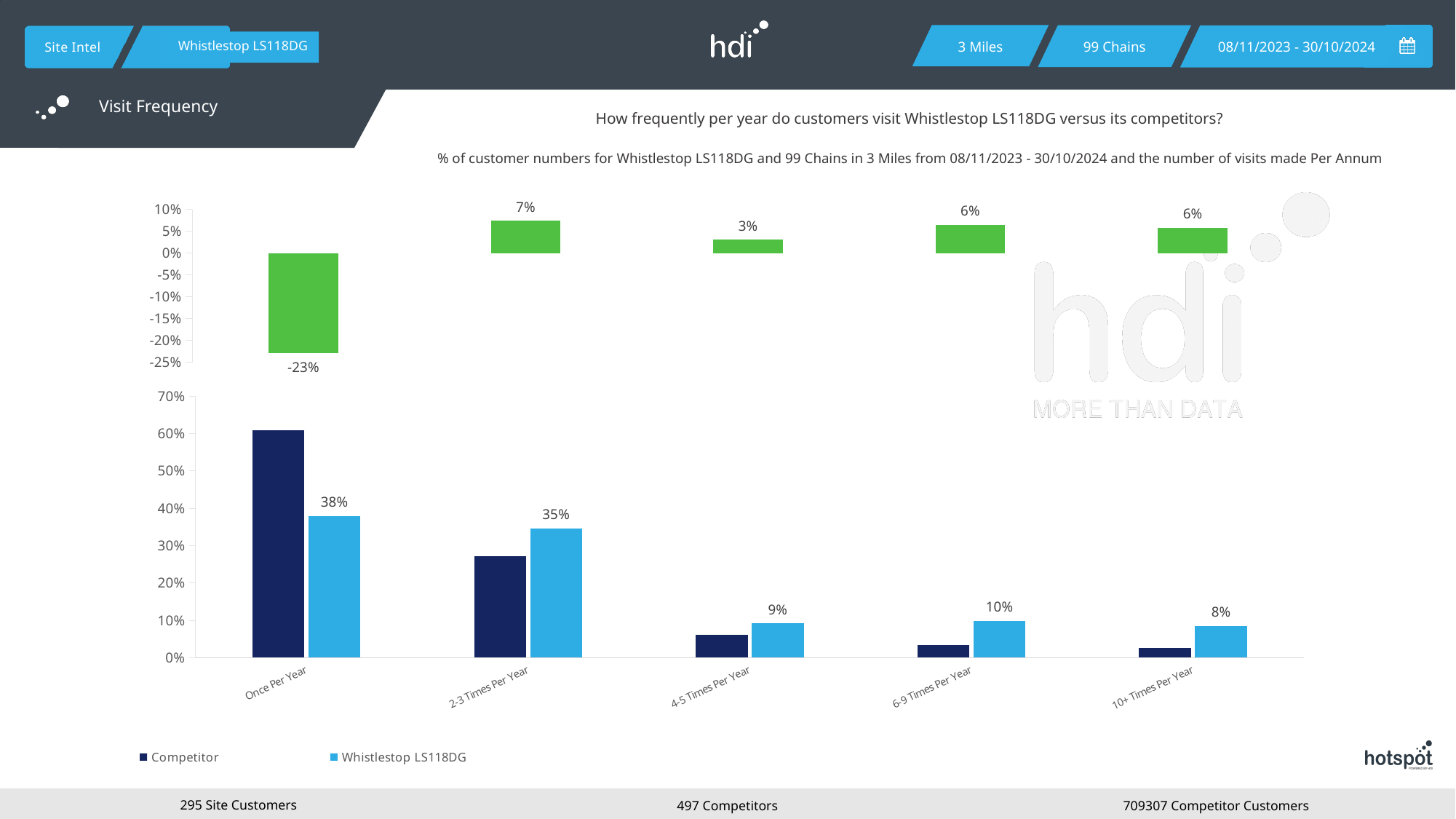
In the bottom chart, for Once Per Year, which series has the larger value: Competitor or Whistlestop LS118DG? Competitor In the bottom chart, is the Competitor value for Once Per Year greater or less than 50%? greater In the bottom chart, which category has the highest Whistlestop LS118DG value? Once Per Year In the top chart (green bars), which category has the lowest value? Once Per Year In the top chart (green bars), what is the value for 2-3 Times Per Year? 7% In the top chart (green bars), which category has the highest value? 2-3 Times Per Year In the bottom chart, which category has the lowest Whistlestop LS118DG value? 10+ Times Per Year In the bottom chart, what percentage of Whistlestop LS118DG customers visit Once Per Year? 38% In the bottom chart, is the Competitor value for 2-3 Times Per Year greater or less than 30%? less In the bottom chart, what is the difference between the Whistlestop LS118DG values for Once Per Year and 2-3 Times Per Year? 3 percentage points How many visit-frequency categories are shown on the x axis of the bottom chart? 5 How many series does the legend of the bottom chart list? 2